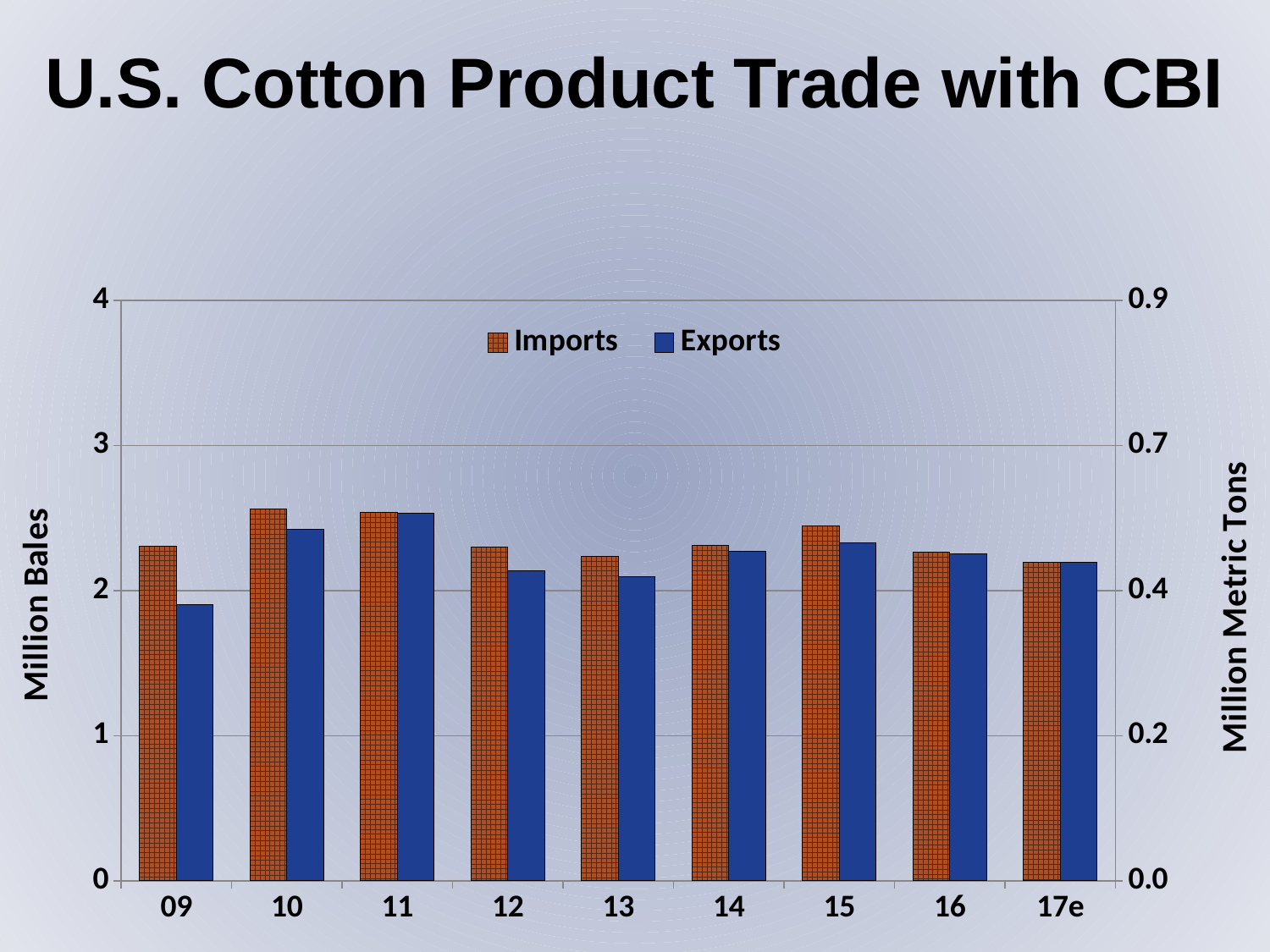
What is the label on the left vertical axis? Million Bales Do the Exports values rise or fall from 11 to 13? fall Is the Imports value for 10 greater or less than 2 million bales? greater Is the Imports value for 15 greater or less than 3 million bales? less Which year has the highest Exports value? 11 Which year has the lowest Exports value? 09 In 09, which is larger, Imports or Exports? Imports How many series does the legend list? 2 What kind of chart is shown on the slide? bar chart In 12, which is larger, Imports or Exports? Imports How many years are shown along the x axis? 9 Is the Exports value for 09 greater or less than 2 million bales? less